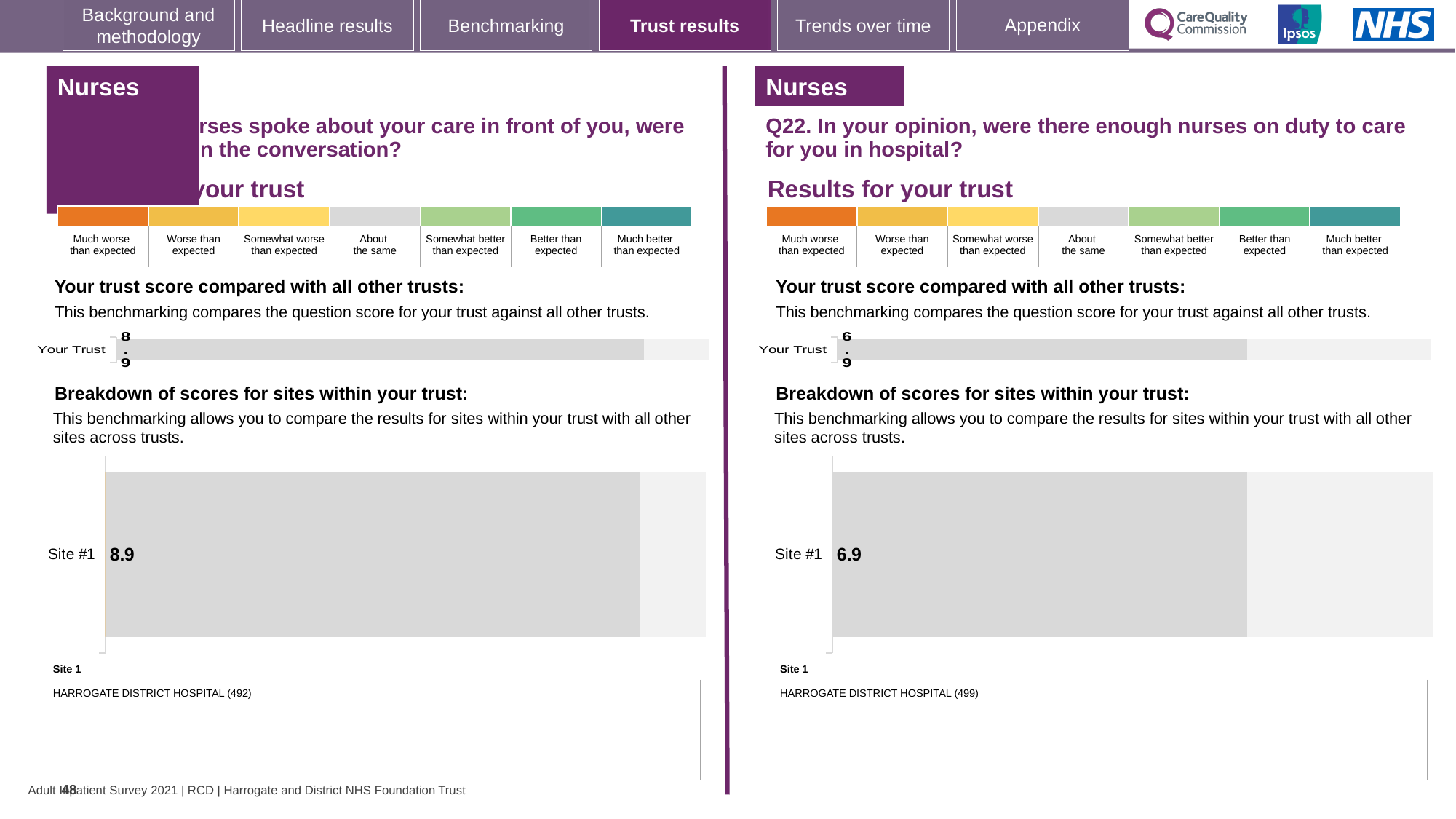
What is the difference between the Site #1 score on the left-hand chart and the Site #1 score on the Q22 chart? 2.0 Which site is listed as Site 1 beneath the left-hand breakdown chart? HARROGATE DISTRICT HOSPITAL (492) Which site is listed as Site 1 beneath the Q22 breakdown chart? HARROGATE DISTRICT HOSPITAL (499) In the Q22 breakdown of scores for sites within your trust, what is the score for Site #1? 6.9 How many sites are shown in the Q22 breakdown of scores for sites within your trust? 1 Which is larger: the Site #1 score in the left-hand chart or the Site #1 score in the Q22 chart on the right? The left-hand chart (8.9) What type of chart is used to show the Site #1 score in the Q22 breakdown? Bar chart In the left-hand breakdown of scores for sites within your trust, what is the score for Site #1? 8.9 On the left-hand side of the slide, what is the score shown for Your Trust? 8.9 On the right-hand side of the slide (Q22), what is the score shown for Your Trust? 6.9 Is the Your Trust score on the Q22 chart greater or less than the Your Trust score on the left-hand chart? less